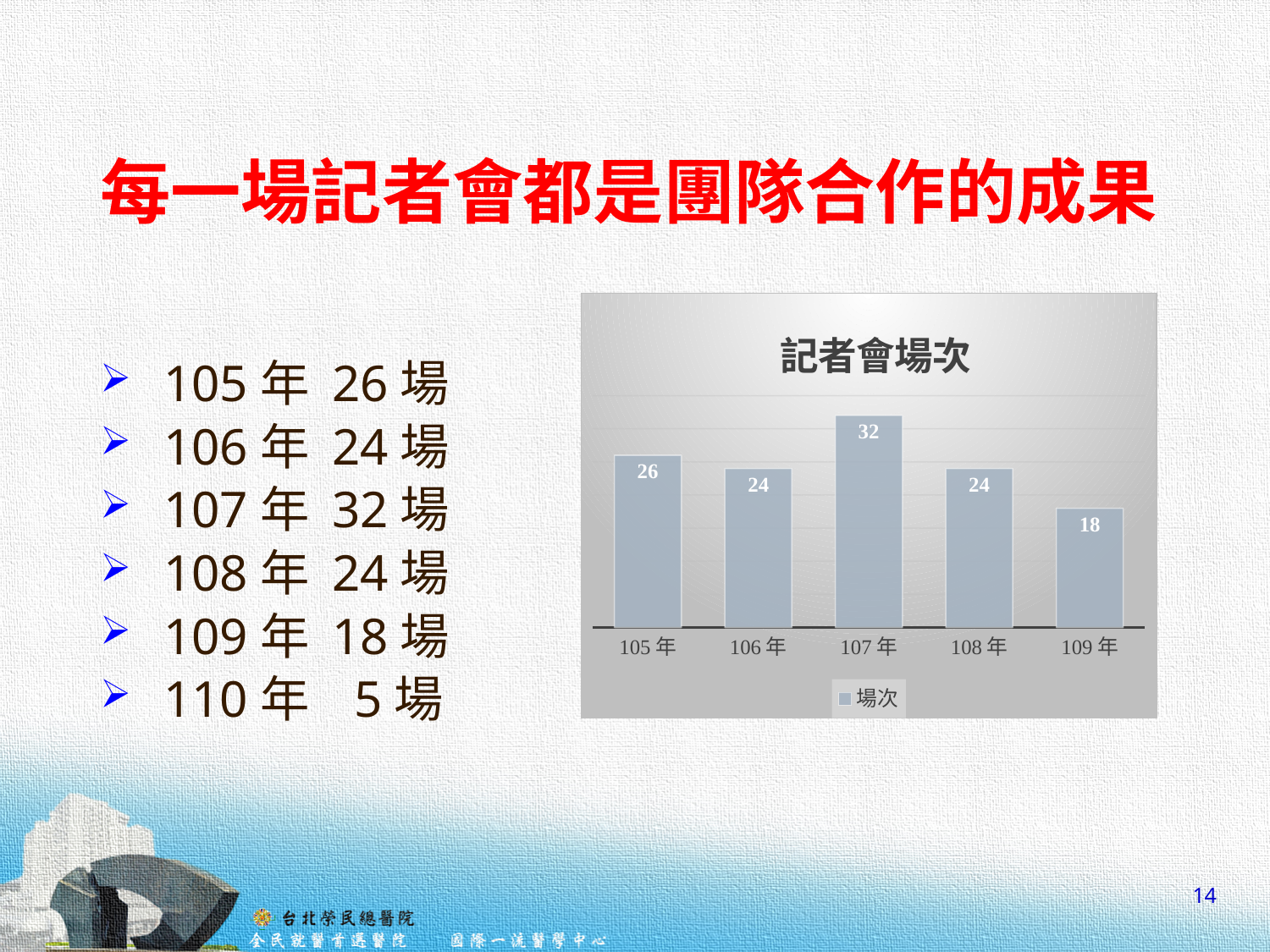
Which year has the lowest value in the 記者會場次 chart? 109 年 Which is larger in the 記者會場次 chart, the value for 105 年 or the value for 108 年? 105 年 What is the value for 109 年 in the 記者會場次 chart? 18 What is the difference between the values for 107 年 and 109 年 in the 記者會場次 chart? 14 Which year has the highest value in the 記者會場次 chart? 107 年 How many years are shown on the x axis of the 記者會場次 chart? 5 What is the value for 105 年 in the 記者會場次 chart? 26 What kind of chart is the 記者會場次 chart? bar chart What is the value for 107 年 in the 記者會場次 chart? 32 What is the title of the chart on the slide? 記者會場次 How many series does the legend of the 記者會場次 chart list? 1 What is the difference between the values for 105 年 and 106 年 in the 記者會場次 chart? 2